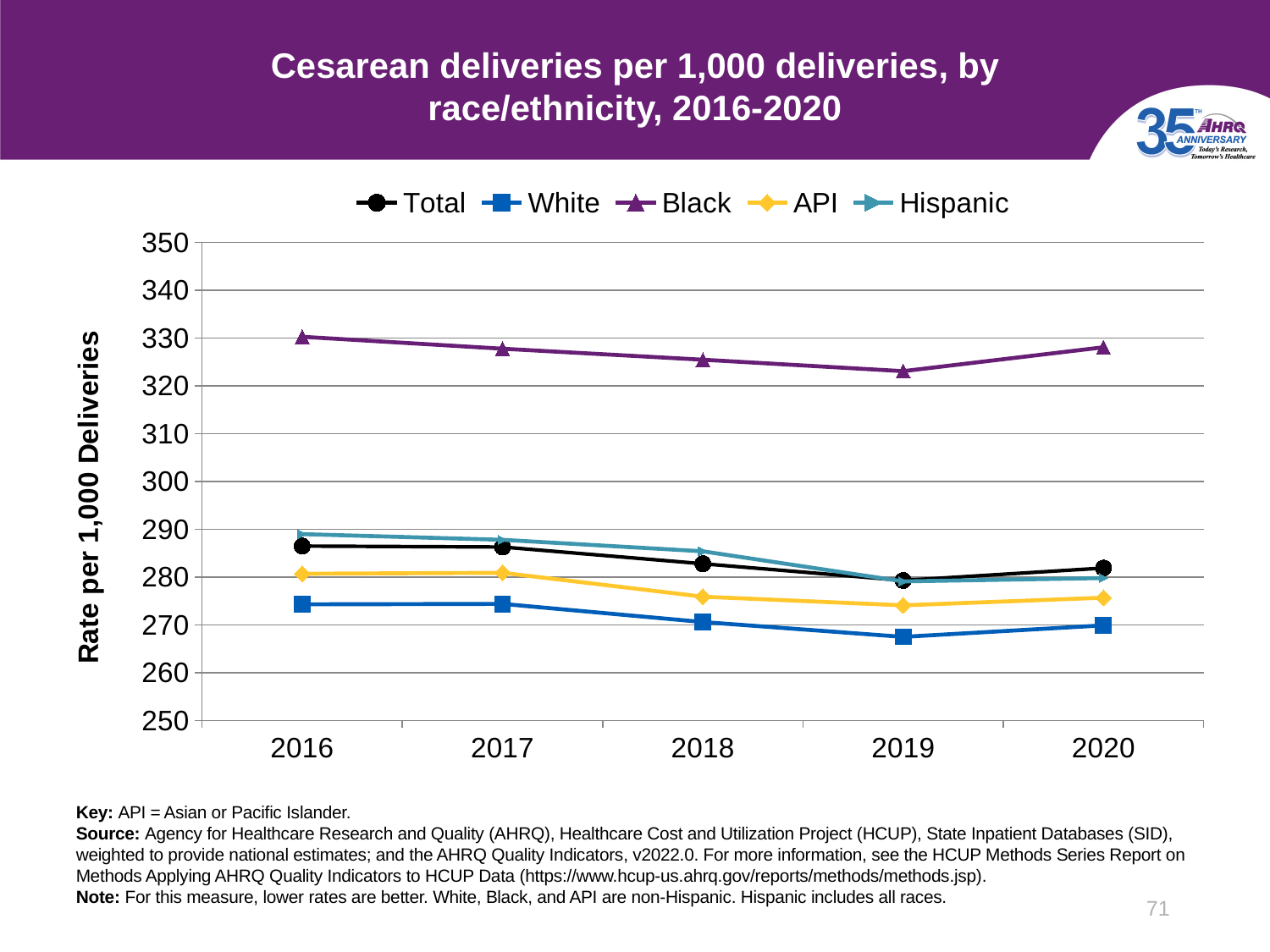
What is the label of the y axis? Rate per 1,000 Deliveries Which race/ethnicity group has the lowest cesarean delivery rate in 2019? White Does the Black rate rise or fall from 2016 to 2019? fall How many series does the legend list? 5 Is the value for API in 2019 greater or less than 280? less Is the value for Black in 2016 greater or less than 320? greater Is the value for White in 2019 greater or less than 270? less What kind of chart is shown on the slide? line chart How many years are plotted along the x axis? 5 Which is larger in 2018, the Total rate or the White rate? Total Which race/ethnicity group has the highest cesarean delivery rate in 2020? Black In which year is the Black rate at its lowest? 2019